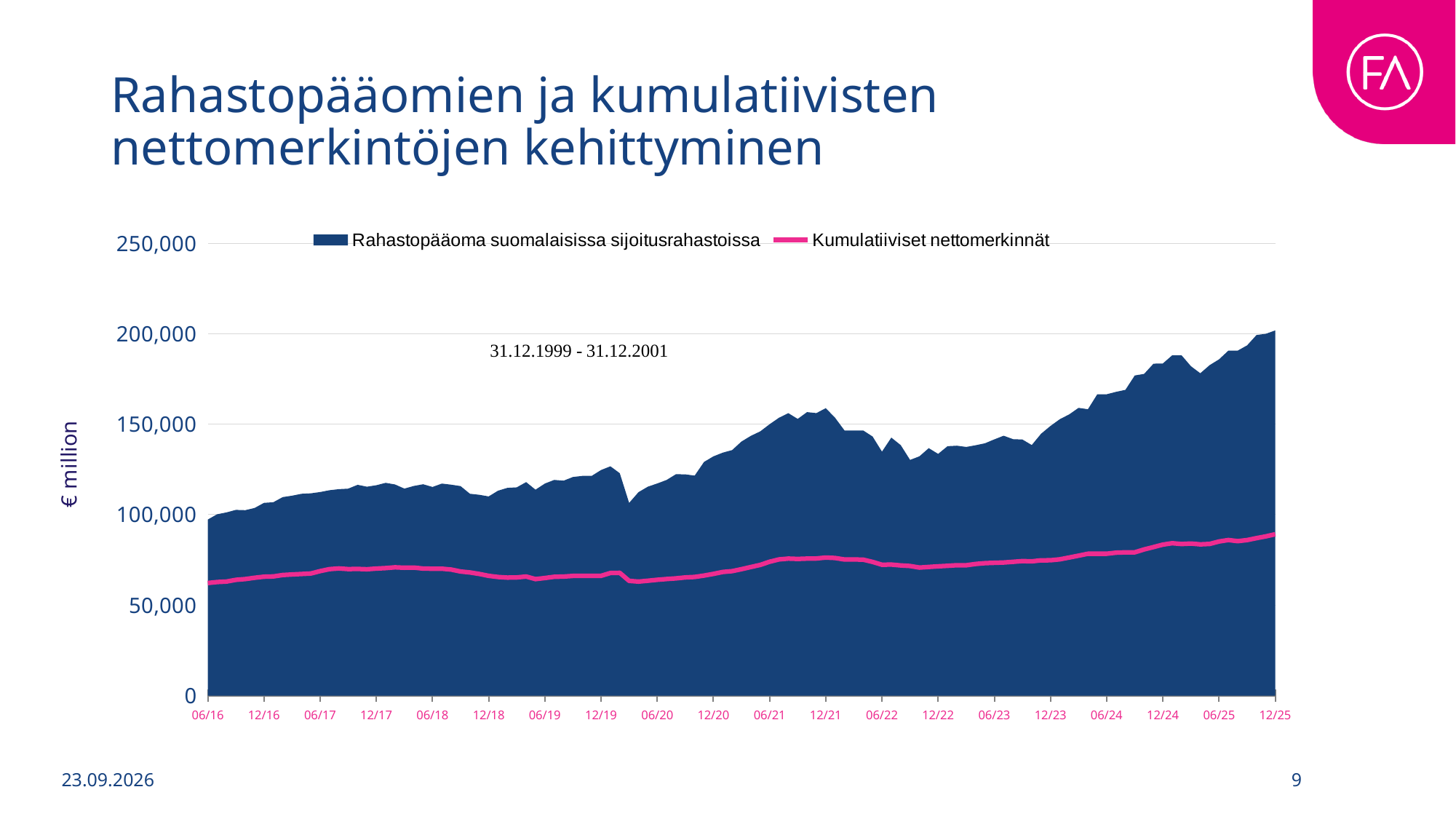
At 12/25, which series has the higher value, Rahastopääoma suomalaisissa sijoitusrahastoissa or Kumulatiiviset nettomerkinnät? Rahastopääoma suomalaisissa sijoitusrahastoissa Is the value of Rahastopääoma suomalaisissa sijoitusrahastoissa at 06/16 greater or less than 150,000? less How many series does the chart legend list? 2 What are the two series named in the chart legend? Rahastopääoma suomalaisissa sijoitusrahastoissa; Kumulatiiviset nettomerkinnät Is the value of Rahastopääoma suomalaisissa sijoitusrahastoissa at 12/25 greater or less than 150,000? greater At which x-axis date does Rahastopääoma suomalaisissa sijoitusrahastoissa reach its highest value? 12/25 Is the value of Kumulatiiviset nettomerkinnät at 12/25 greater or less than 100,000? less What kind of chart is shown on the slide? area chart with a line Does Rahastopääoma suomalaisissa sijoitusrahastoissa overall rise or fall from 06/16 to 12/25? rise What unit is shown on the vertical axis of the chart? € million